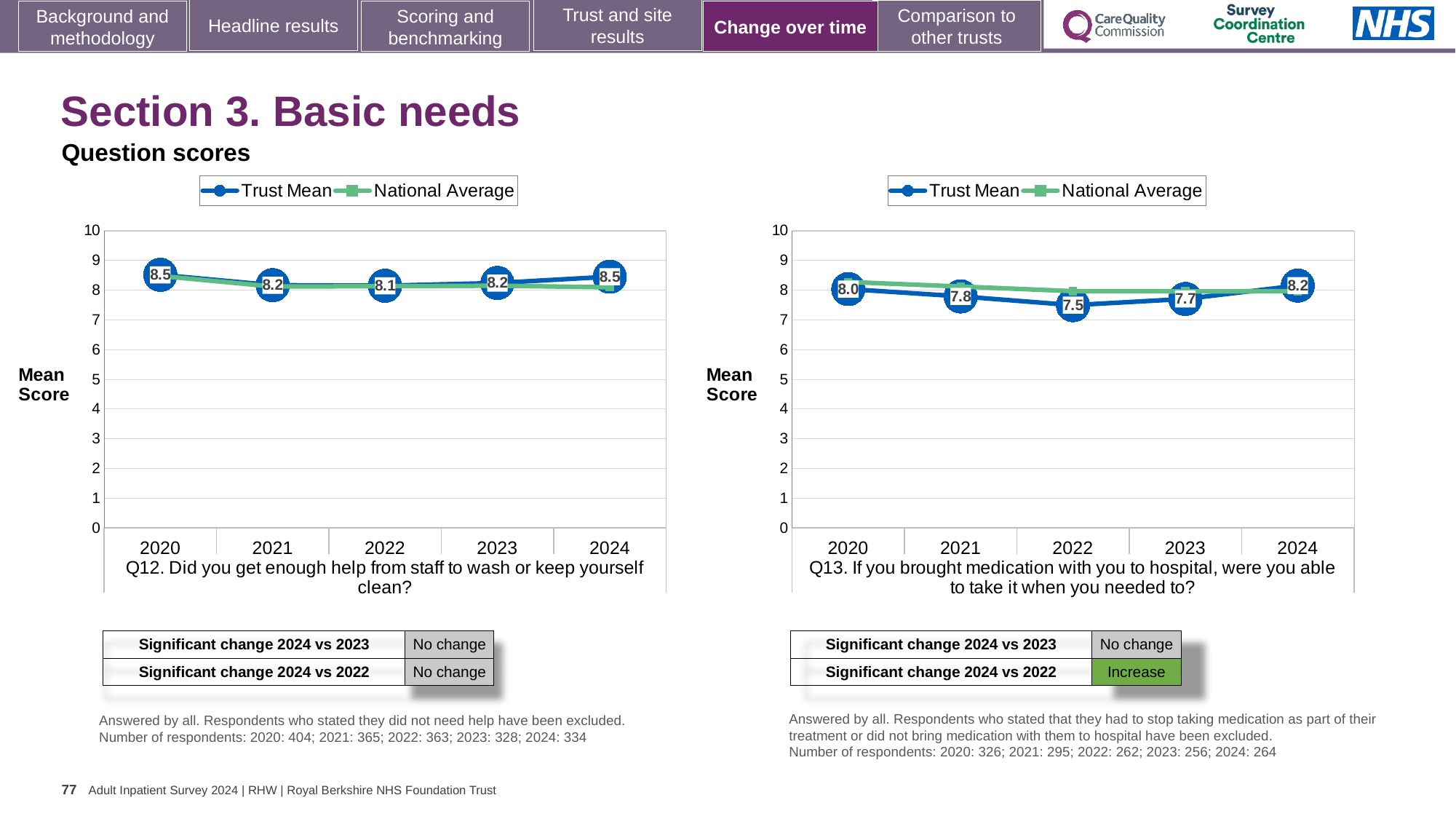
How many series does the legend of the Q13 chart (right) list? 2 In the Q13 chart (right), which year has the lowest Trust Mean score? 2022 In the Q12 chart (left), what is the Trust Mean score for 2022? 8.1 In the Q12 chart (left), is the National Average for 2020 greater or less than 7? greater In the Q13 chart (right), which year has the highest Trust Mean score? 2024 In the Q13 chart (right), what is the difference between the Trust Mean scores for 2024 and 2022? 0.7 What type of chart is used for Q13 (right)? Line chart In the Q13 chart (right), what is the Trust Mean score for 2022? 7.5 In the Q13 chart (right), what is the Trust Mean score for 2024? 8.2 How many years are plotted on the x axis of the Q12 chart (left)? 5 In the Q12 chart (left), is the Trust Mean score for 2021 larger or smaller than the score for 2024? smaller In the Q12 chart (left), what is the Trust Mean score for 2024? 8.5